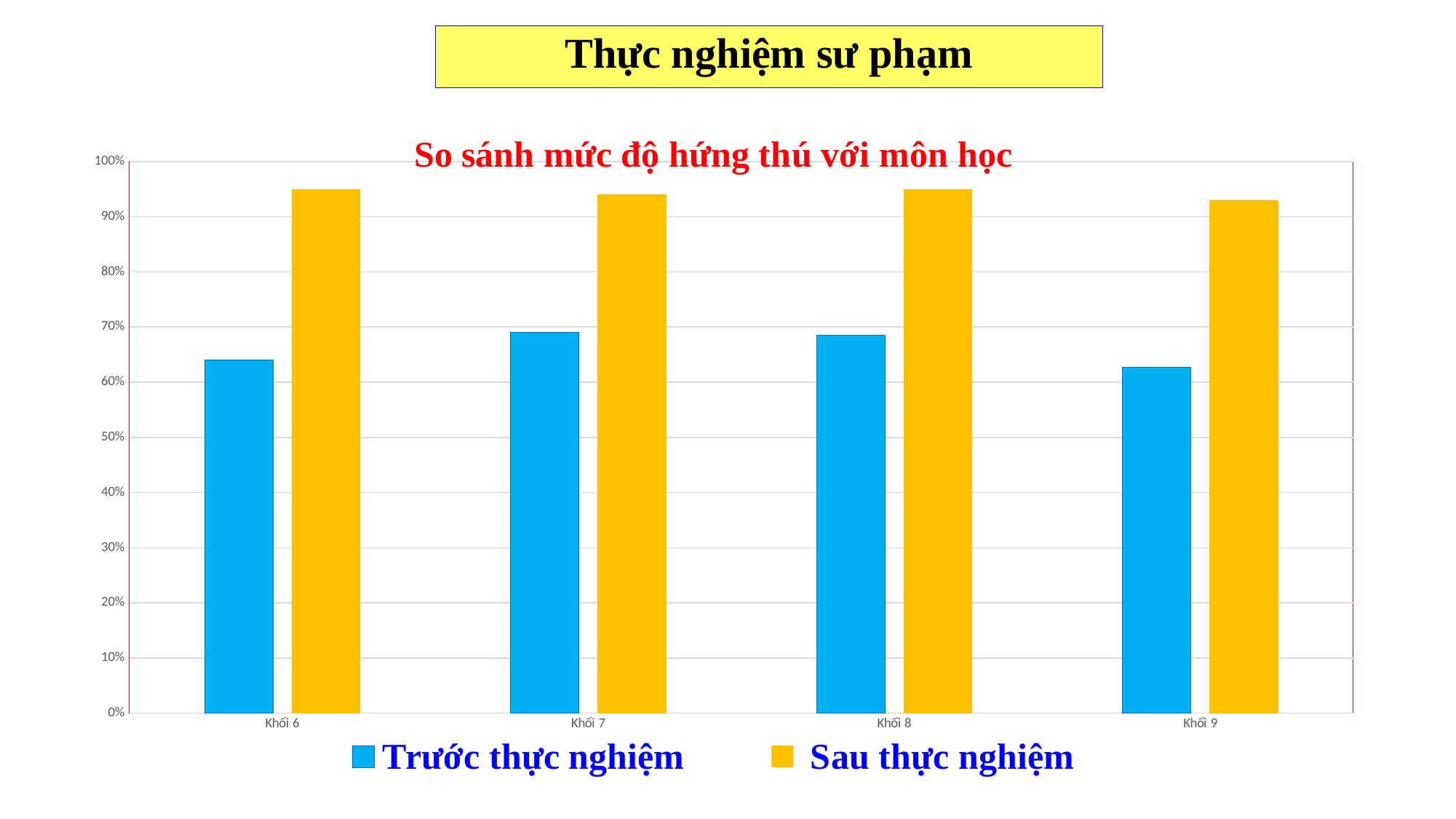
How many series does the chart's legend list? 2 What kind of chart is shown on the slide? bar chart Is the value for Trước thực nghiệm at Khối 6 greater or less than 60%? greater For Trước thực nghiệm, which is larger: Khối 7 or Khối 9? Khối 7 Which series is shown in orange in the chart? Sau thực nghiệm Is the value for Sau thực nghiệm at Khối 9 greater or less than 90%? greater At Khối 6, which is larger: Trước thực nghiệm or Sau thực nghiệm? Sau thực nghiệm Is the value for Trước thực nghiệm at Khối 9 greater or less than 70%? less How many categories (grades) are shown on the x axis of the chart? 4 What is the title of the chart? So sánh mức độ hứng thú với môn học